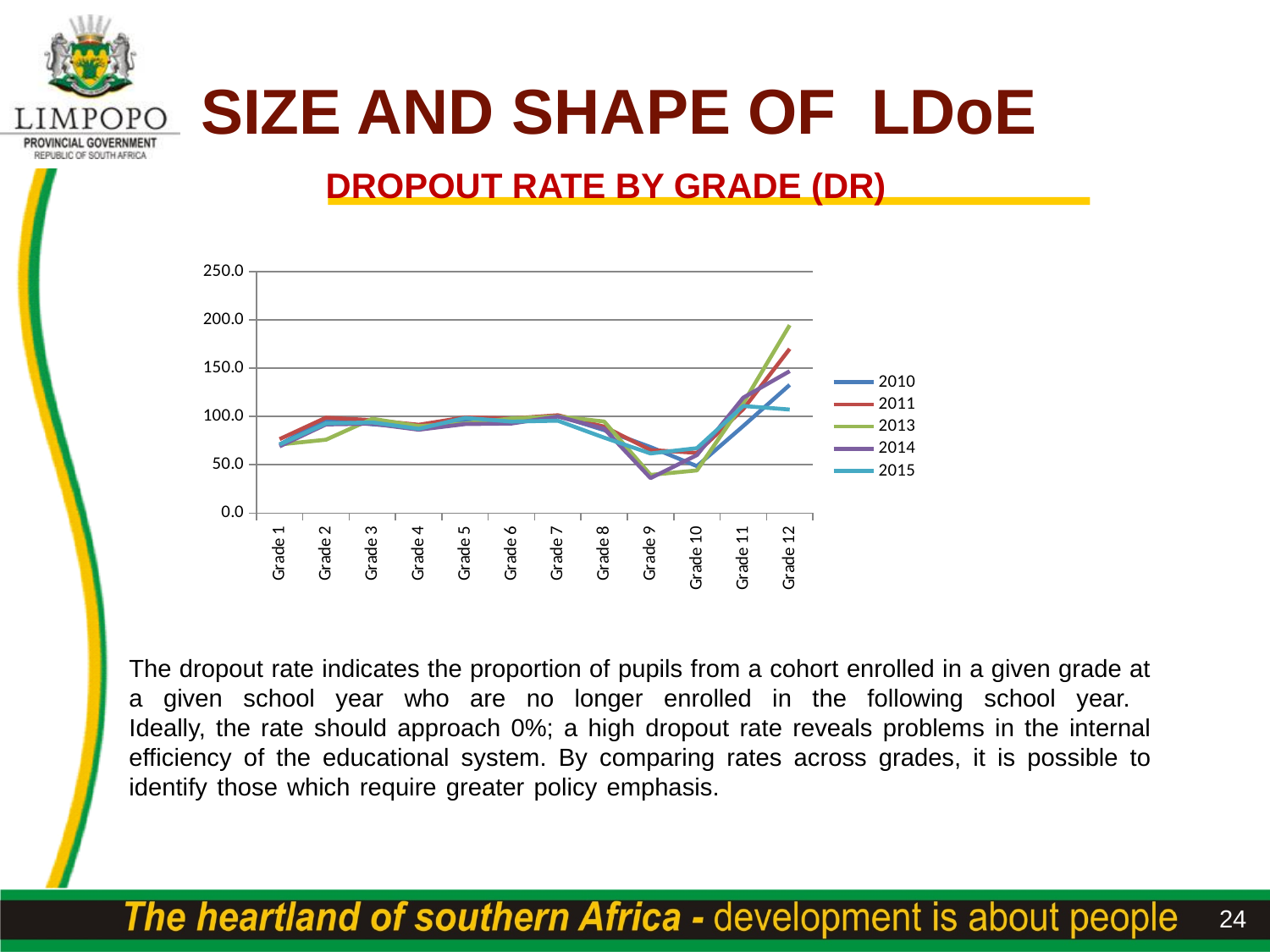
Which series has the highest value at Grade 12? 2013 Do the values rise or fall from Grade 10 to Grade 12 for the 2013 series? Rise Which series has the lowest value at Grade 12? 2015 How many series does the legend list? 5 How many grade categories are plotted along the x axis? 12 What kind of chart is shown on the slide? Line chart What is the title of the chart? DROPOUT RATE BY GRADE (DR) Is the value for 2014 at Grade 9 greater or less than 50? less Is the value for 2010 at Grade 12 greater or less than 150? less Is the value for 2013 at Grade 12 greater or less than 150? greater Which years are listed in the chart legend? 2010, 2011, 2013, 2014, 2015 At Grade 12, which is larger: the value for 2013 or the value for 2010? 2013